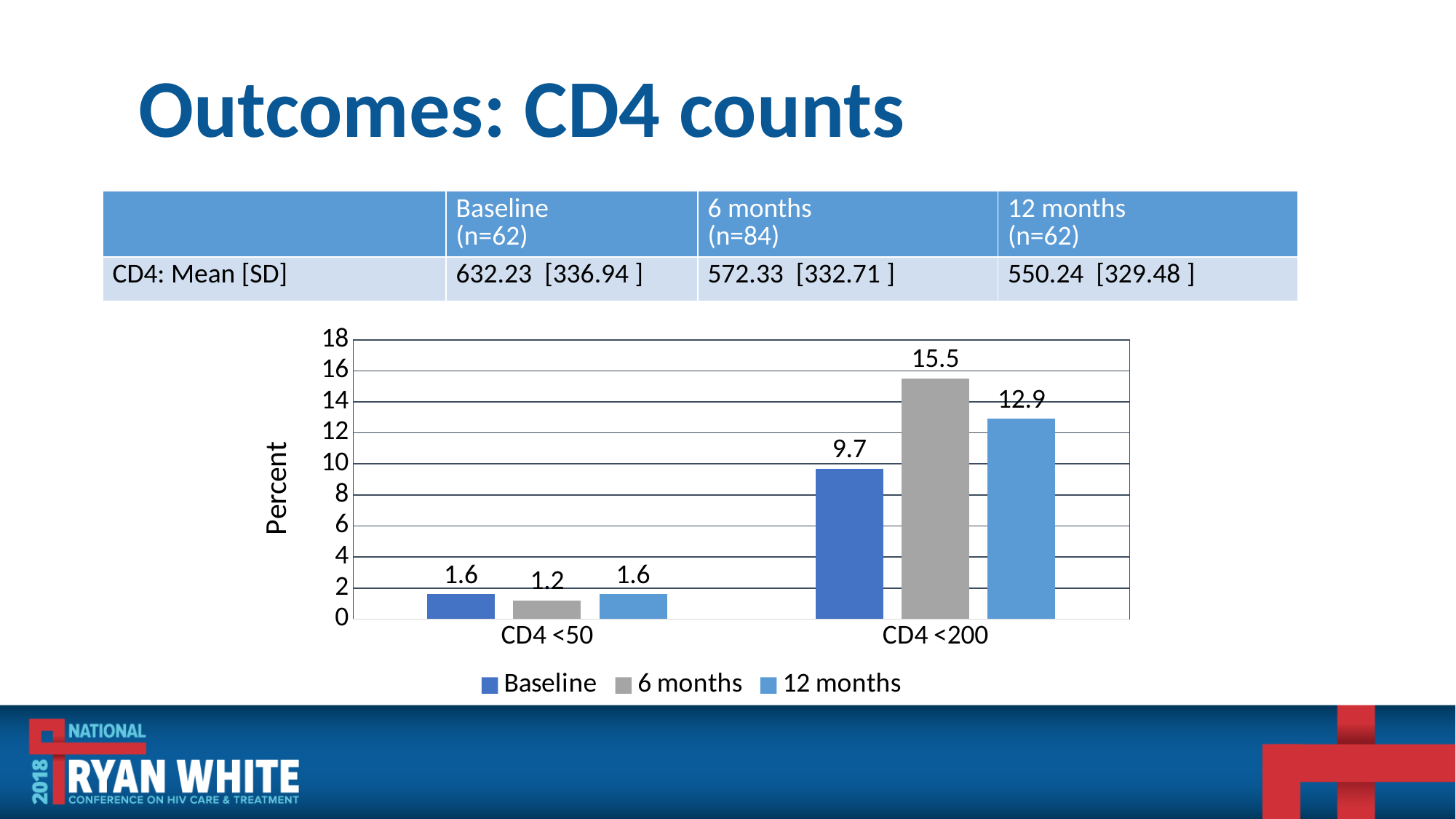
How many series does the legend list? 3 What is the value for Baseline in the CD4 <200 category? 9.7 Which is larger in the CD4 <200 category: the 6 months value or the 12 months value? 6 months What is the difference between the 6 months and Baseline values in the CD4 <200 category? 5.8 Is the value for 6 months in the CD4 <200 category greater or less than 14? greater Which series has the highest value in the CD4 <200 category? 6 months How many categories are shown on the x axis? 2 What kind of chart is shown on the slide? Bar chart Which series has the lowest value in the CD4 <50 category? 6 months What is the value for 6 months in the CD4 <50 category? 1.2 What is the value for 12 months in the CD4 <200 category? 12.9 What is the label of the y axis? Percent